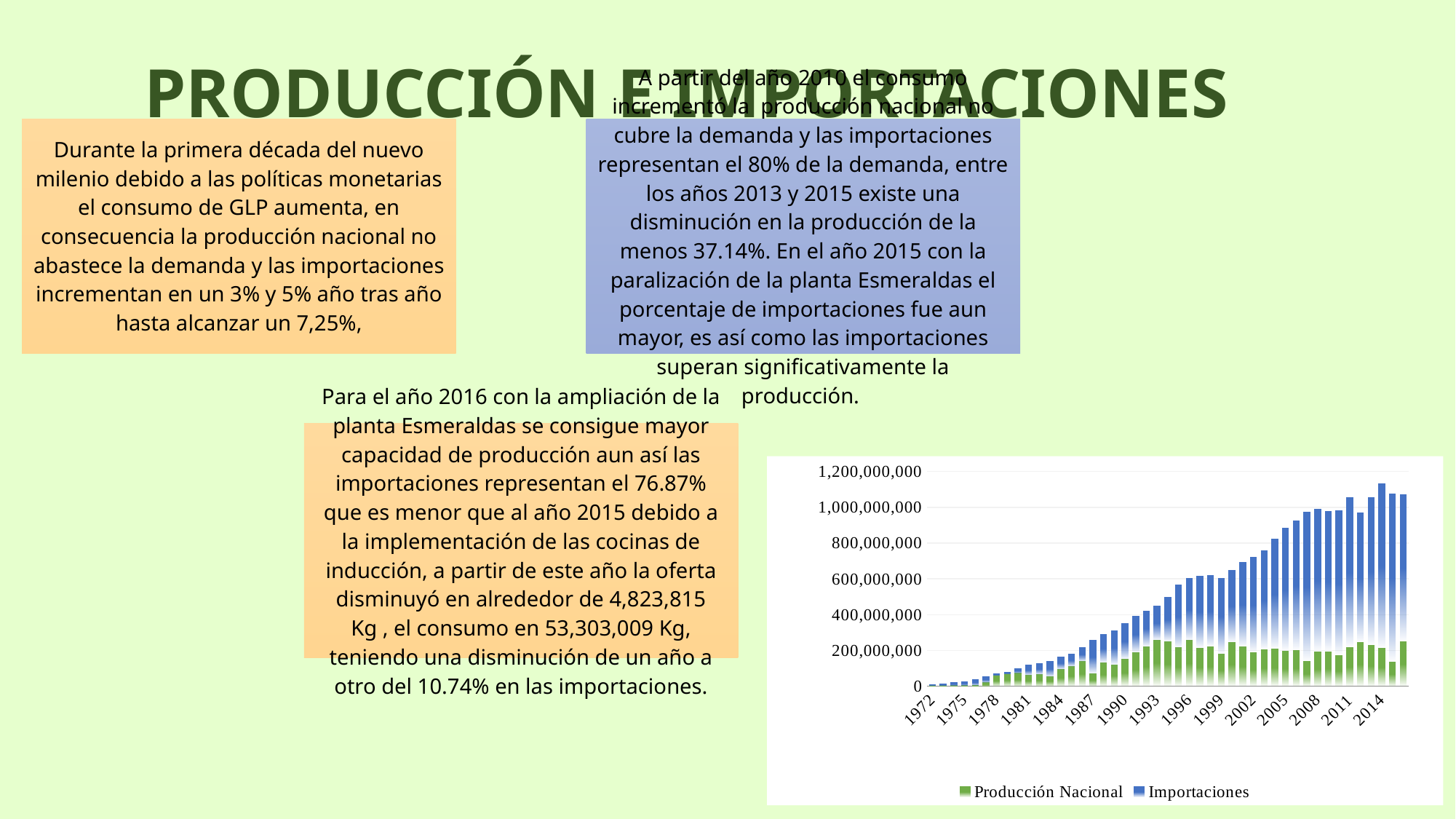
What is the highest value shown on the chart's vertical axis? 1,200,000,000 Do the total bar heights generally rise or fall from 1972 to 2014? rise Is the total value for 1984 greater or less than 400,000,000? less How many series does the chart legend list? 2 Is the total value for 1972 greater or less than 200,000,000? less Is the total value for 2008 greater or less than 800,000,000? greater In 2014, which series is larger, Producción Nacional or Importaciones? Importaciones Which is larger, the total bar for 2008 or the total bar for 1990? 2008 What kind of chart is shown on the slide? stacked bar chart What are the two series named in the chart legend? Producción Nacional and Importaciones Which colour represents Importaciones in the chart? blue